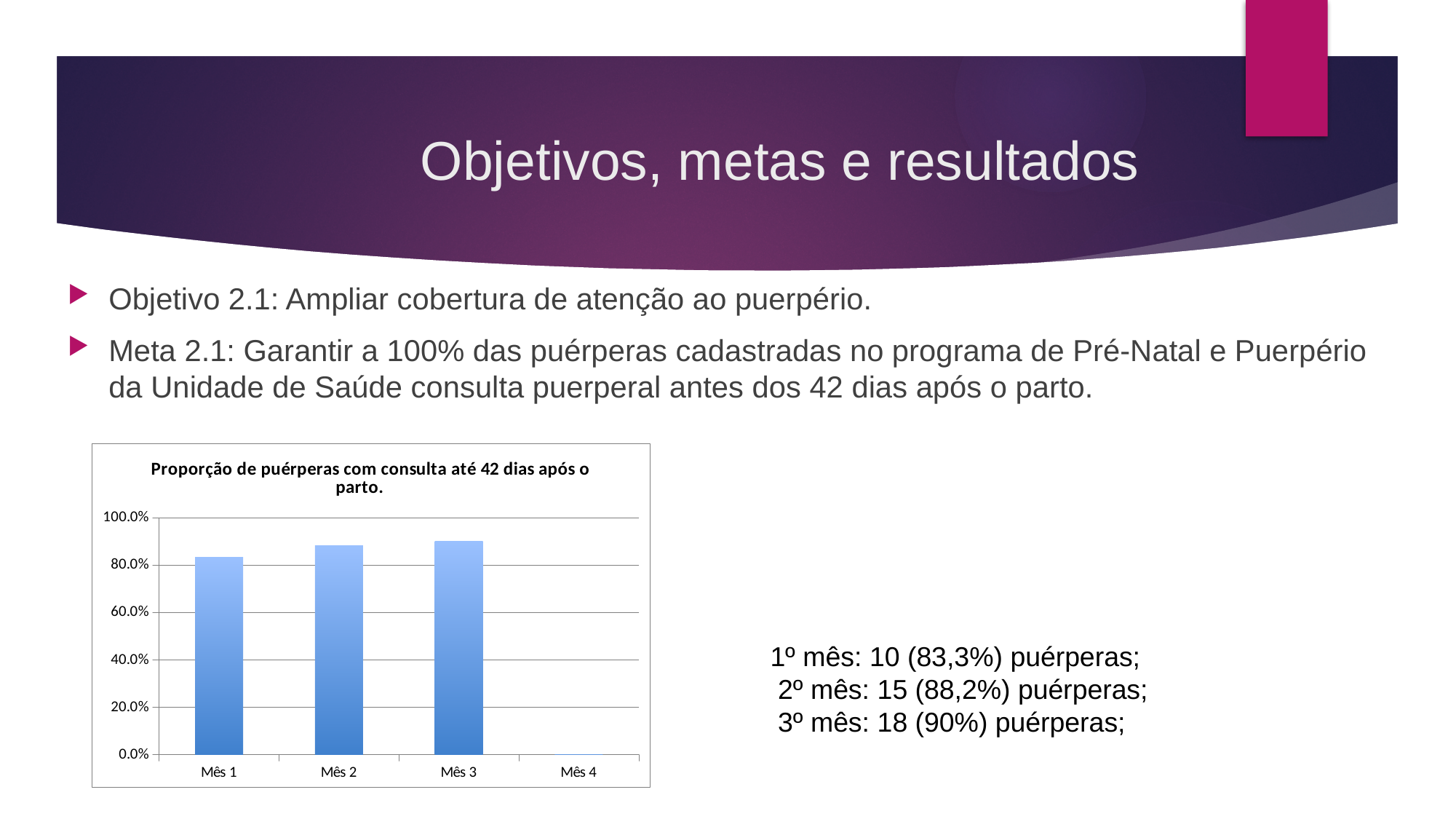
Is the value for Mês 1 greater or less than 60.0%? greater Which is larger, the value for Mês 1 or the value for Mês 3? Mês 3 Do the values rise or fall from Mês 1 to Mês 3? rise What is the value for Mês 4 in the chart? 0.0% How many categories are shown on the x axis of the chart? 4 What kind of chart is shown on the slide? bar chart What is the title of the chart? Proporção de puérperas com consulta até 42 dias após o parto. Is the value for Mês 3 greater or less than 80.0%? greater Which is larger, the value for Mês 1 or the value for Mês 4? Mês 1 Is the value for Mês 2 greater or less than 80.0%? greater Which category has the lowest value in the chart? Mês 4